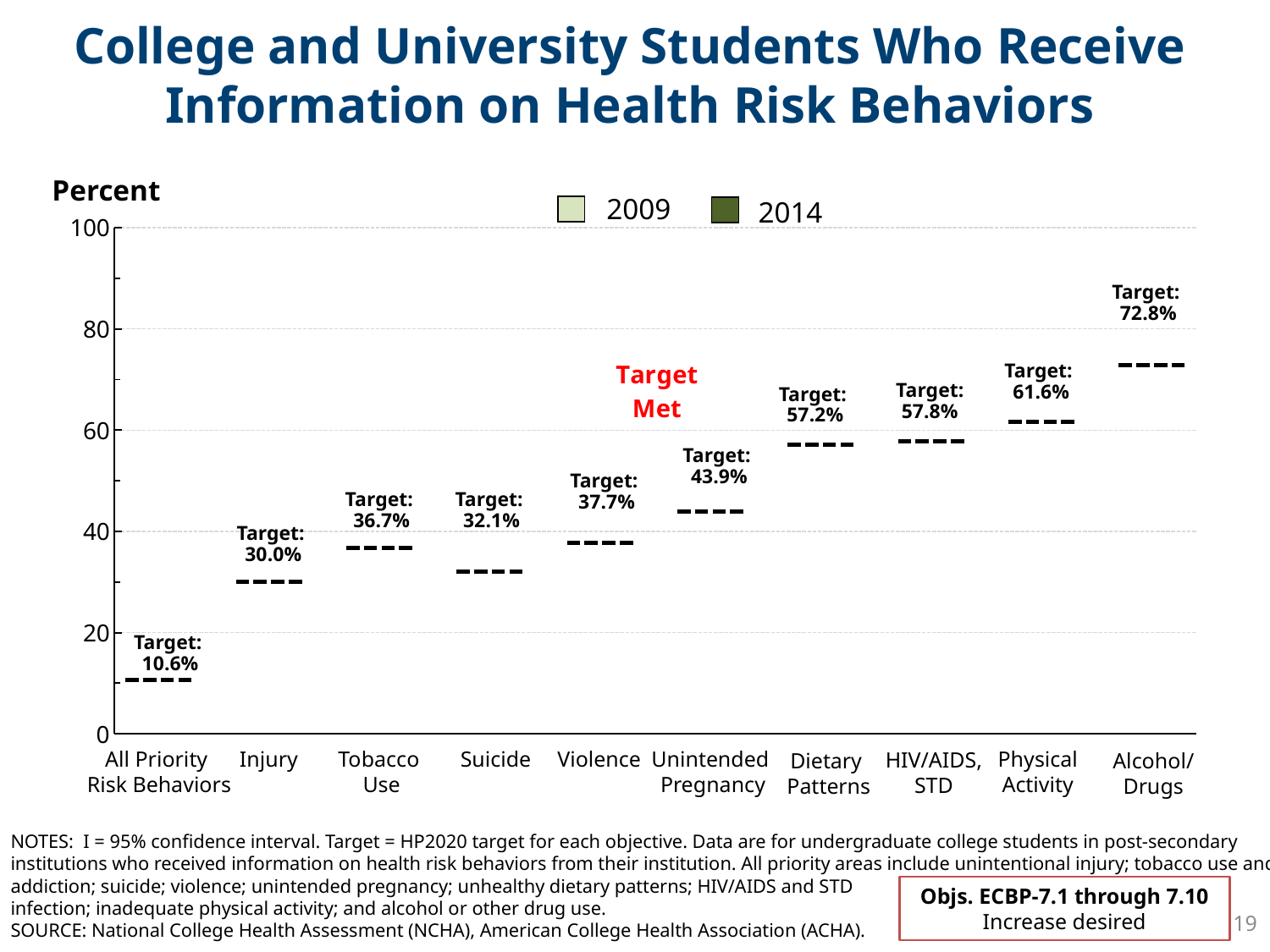
Which category has the highest target value on the chart? Alcohol/Drugs What is the HP2020 target shown for Alcohol/Drugs? 72.8% What is the HP2020 target shown for Injury? 30.0% What is the difference between the target for Physical Activity and the target for Dietary Patterns? 4.4 percentage points Which category has the lowest target value on the chart? All Priority Risk Behaviors How many series does the legend list? 2 Is the target for Unintended Pregnancy greater or less than 40? greater What is the difference between the target for Alcohol/Drugs and the target for All Priority Risk Behaviors? 62.2 percentage points How many categories are shown on the x axis of the chart? 10 Which has the larger target, Tobacco Use or Suicide? Tobacco Use What is the HP2020 target shown for HIV/AIDS, STD? 57.8%